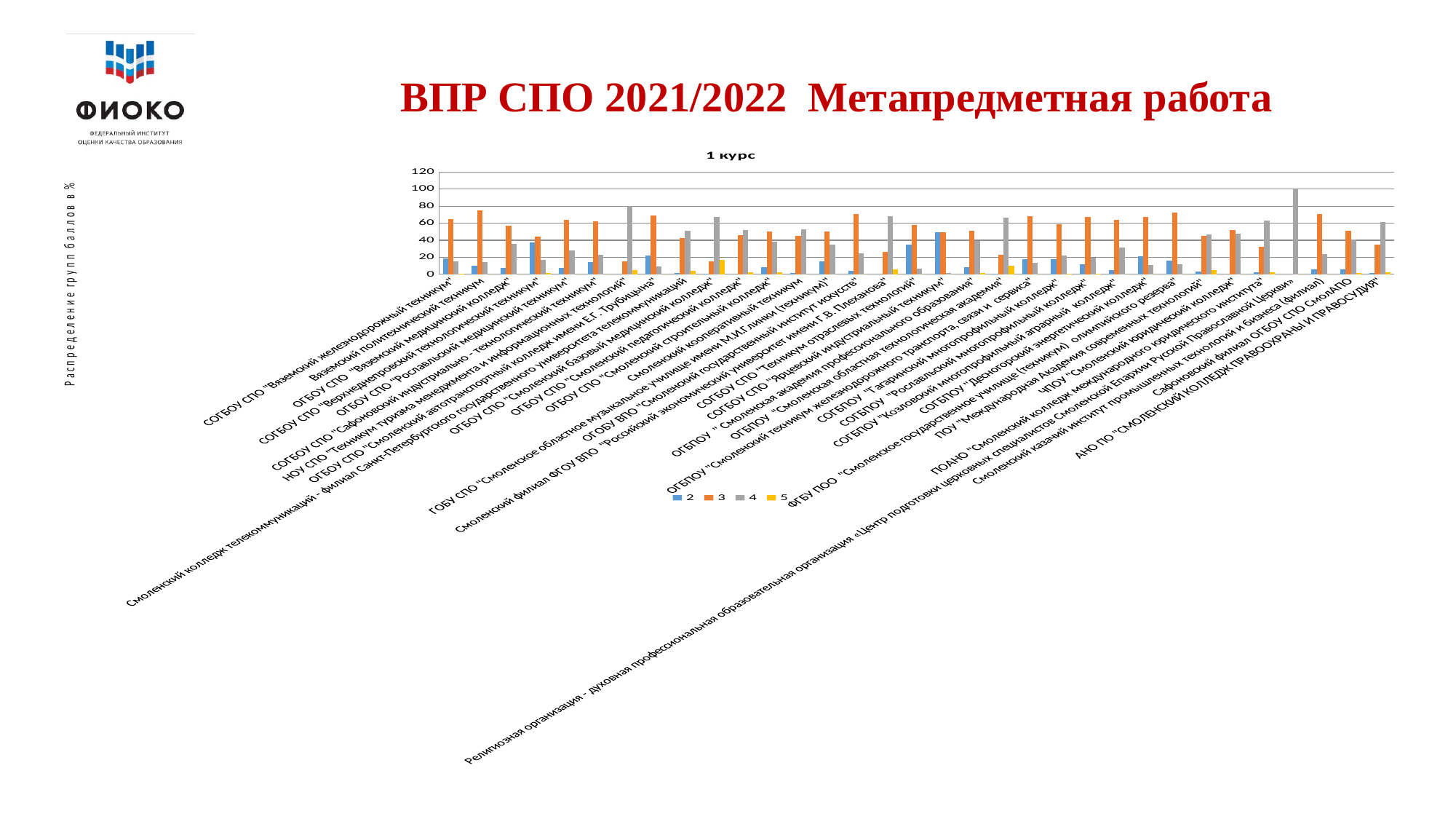
Is the value of series 2 for СОГБОУ СПО "Вяземский железнодорожный техникум" greater or less than 40? less What kind of chart is shown on the slide? bar chart For the Религиозная организация «Центр подготовки церковных специалистов Смоленской Епархии Русской Православной Церкви», which is larger: series 3 or series 4? 4 How many series does the chart legend list? 4 What are the series names listed in the chart legend? 2, 3, 4, 5 Which series has the single tallest bar in the chart? 4 Is the value of series 3 for СОГБОУ СПО "Вяземский железнодорожный техникум" greater or less than 40? greater Is the value of series 3 for Вяземский политехнический техникум greater or less than 60? greater For СОГБОУ СПО "Вяземский железнодорожный техникум", which is larger: series 2 or series 3? 3 What is the title of the chart? 1 курс For which category does series 4 reach its highest value? Религиозная организация - Духовная профессиональная образовательная организация «Центр подготовки церковных специалистов Смоленской Епархии Русской Православной Церкви»